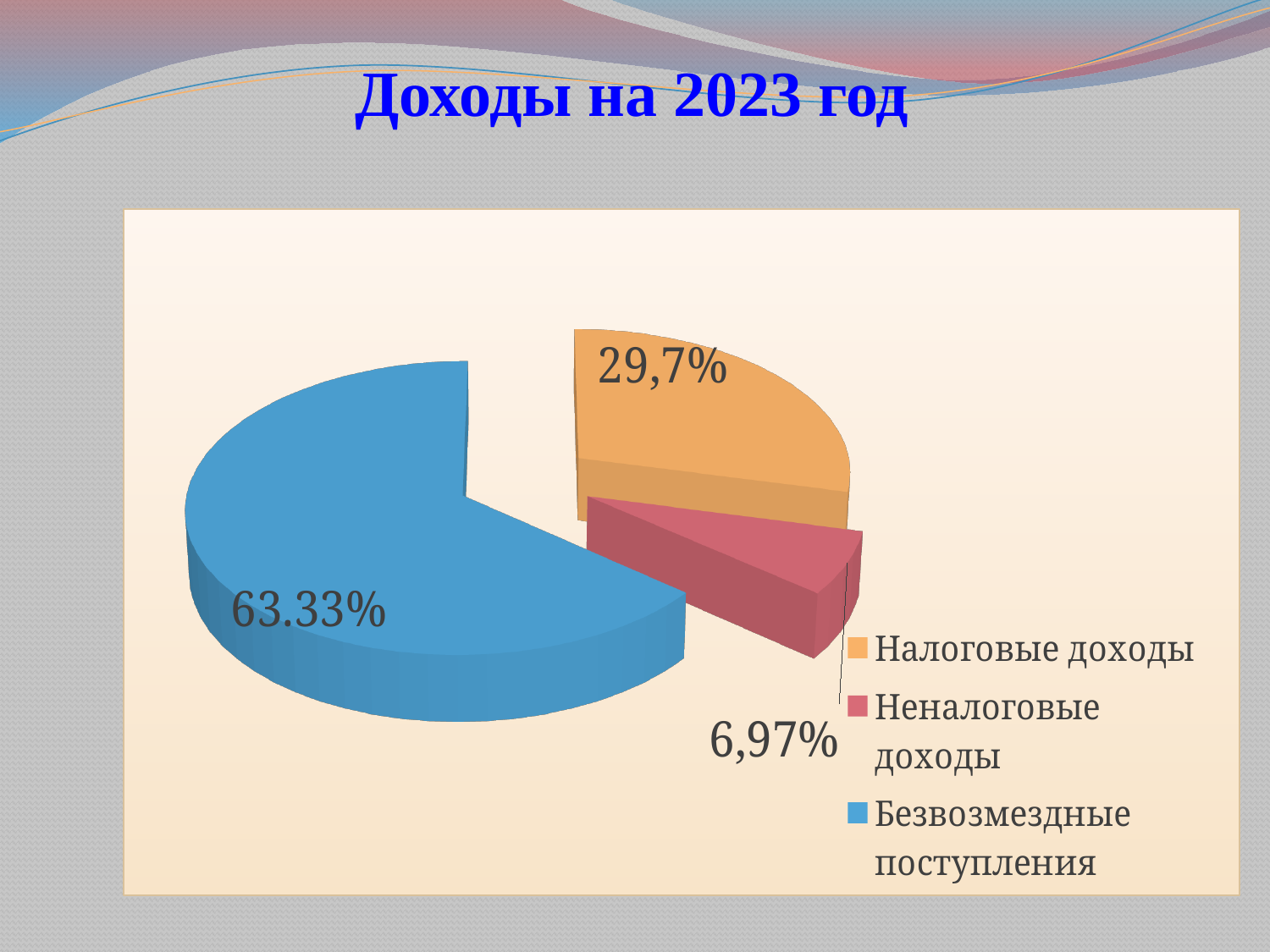
What type of chart is shown on the slide? pie chart What share of the pie is Налоговые доходы? 29,7% What is the title of the chart on the slide? Доходы на 2023 год What is the difference between the share for Налоговые доходы and the share for Неналоговые доходы? 22,73% How many entries does the legend list? 3 Which is larger: the share for Налоговые доходы or the share for Неналоговые доходы? Налоговые доходы How many slices does the pie chart have? 3 Which category has the smallest share of the pie? Неналоговые доходы What share of the pie is Безвозмездные поступления? 63.33% Which category has the largest share of the pie? Безвозмездные поступления What colour is the slice for Безвозмездные поступления? blue What share of the pie is Неналоговые доходы? 6,97%